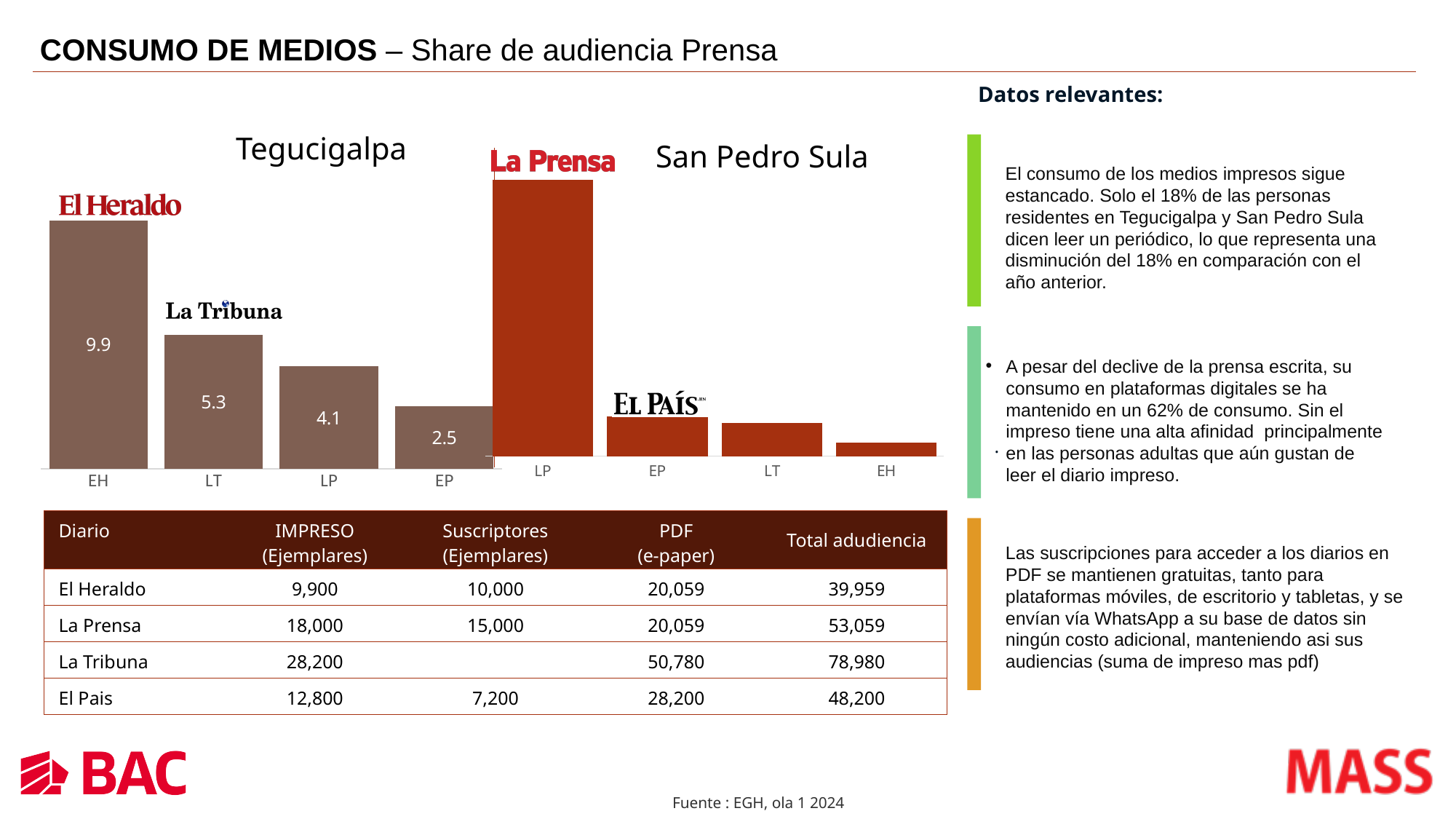
In the Tegucigalpa chart, what is the value for EH? 9.9 In the Tegucigalpa chart, what is the value for LT? 5.3 In the Tegucigalpa chart, what is the difference between the values for EH and LT? 4.6 In the San Pedro Sula chart, which is larger, the value for EP or the value for EH? EP In the Tegucigalpa chart, what is the difference between the values for LP and EP? 1.6 In the San Pedro Sula chart, which category has the highest value? LP In the Tegucigalpa chart, which category has the lowest value? EP What kind of chart is the San Pedro Sula chart? Bar chart In the Tegucigalpa chart, which category has the highest value? EH In the Tegucigalpa chart, what is the value for EP? 2.5 In the San Pedro Sula chart, which category has the lowest value? EH In the Tegucigalpa chart, how many categories are shown? 4